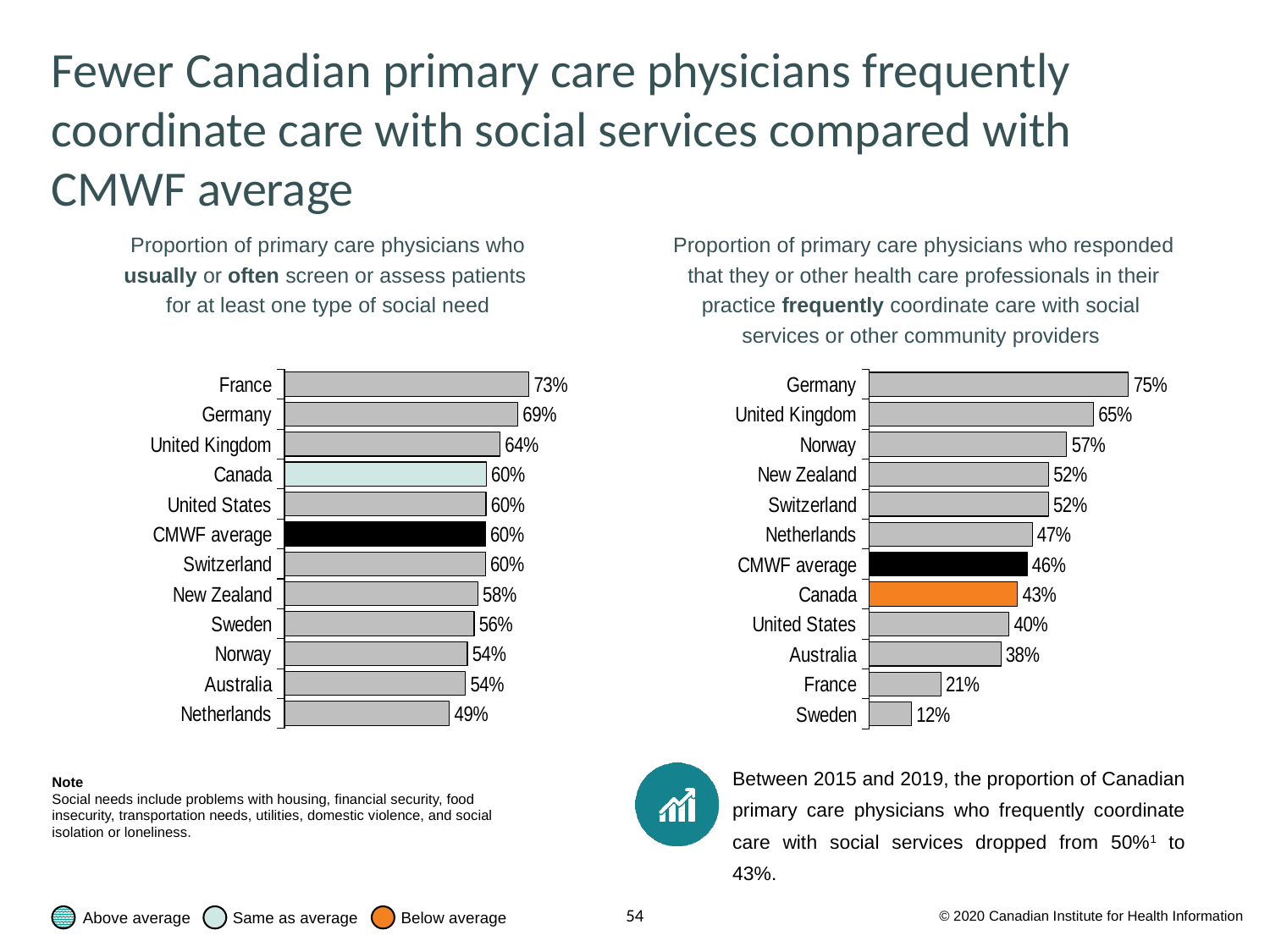
In the left chart (screen or assess patients for social need), what is the difference between France and Netherlands? 24 percentage points In the left chart (screen or assess patients for social need), which country has the lowest value? Netherlands In the left chart (screen or assess patients for social need), how many bars are shown? 12 In the right chart (frequently coordinate care with social services), what is the value for Canada? 43% In the right chart (frequently coordinate care with social services), which country has the lowest value? Sweden In the right chart (frequently coordinate care with social services), what is the value for Germany? 75% In the right chart (frequently coordinate care with social services), which is larger, the value for Norway or the value for Netherlands? Norway What type of chart is used on the right side of the slide? Bar chart In the left chart (screen or assess patients for social need), what is the value for Canada? 60% In the right chart (frequently coordinate care with social services), what colour is the bar for Canada? Orange In the right chart (frequently coordinate care with social services), what is the difference between the CMWF average and Canada? 3 percentage points In the left chart (screen or assess patients for social need), what is the value for France? 73%